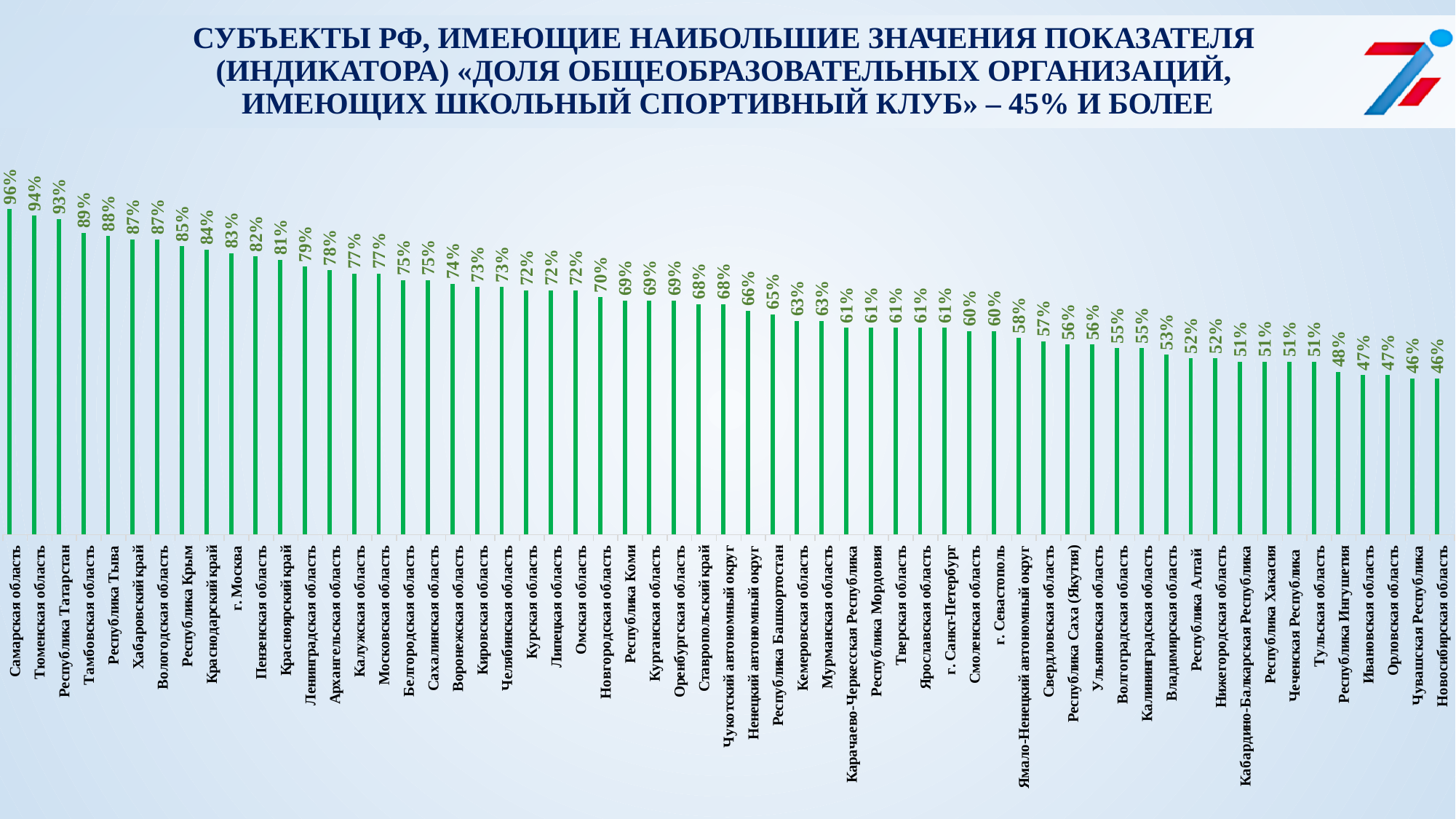
What is the difference between the values for Тюменская область and Республика Татарстан? 1% Which has a larger value, Краснодарский край or Красноярский край? Краснодарский край Which has a larger value, Свердловская область or Ульяновская область? Свердловская область What kind of chart is shown on the slide? Bar chart How many regions are shown on the chart? 59 What is the value for Самарская область? 96% What is the value for г. Санкт-Петербург? 61% What is the value for г. Москва? 83% What is the value for Республика Башкортостан? 65% Which region has the highest value on the chart? Самарская область What is the lowest value shown on the chart? 46% What is the difference between the values for Самарская область and Новосибирская область? 50%